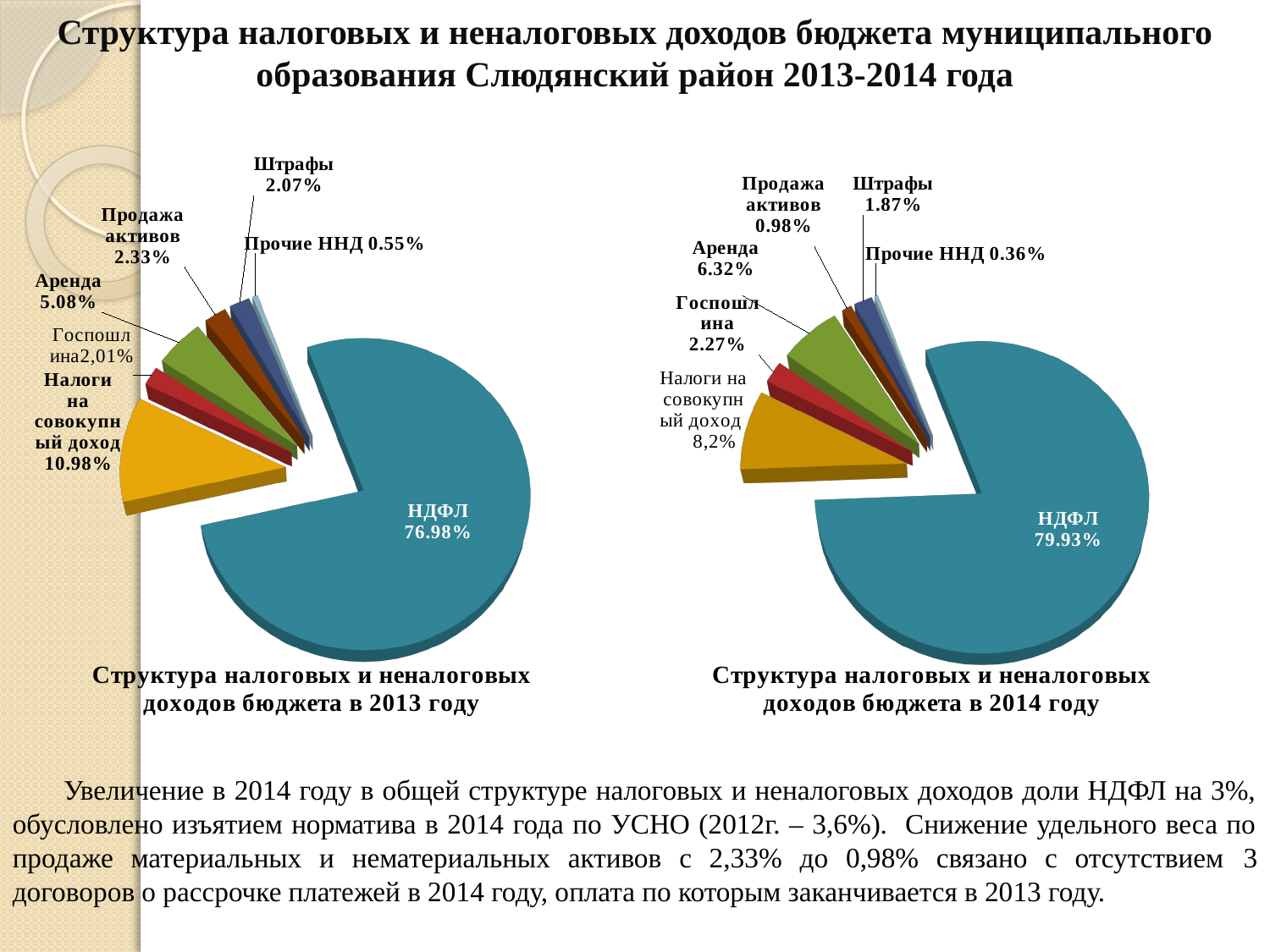
On the 2013 chart, what is the share of Штрафы? 2.07% On the 2014 chart, what is the share of Продажа активов? 0.98% On the 2013 chart (Структура налоговых и неналоговых доходов бюджета в 2013 году), what share does НДФЛ have? 76.98% On the 2014 chart, which category has the largest share? НДФЛ How many slices does the 2014 chart have? 7 On the 2014 chart, what is the share of Аренда? 6.32% By how many percentage points is the НДФЛ share on the 2014 chart larger than on the 2013 chart? 2.95 What type of chart is used on the left side of the slide? Pie chart On the 2013 chart, what is the share of Налоги на совокупный доход? 10.98% On the 2014 chart (Структура налоговых и неналоговых доходов бюджета в 2014 году), what share does НДФЛ have? 79.93% On the 2013 chart, which is larger: the share of Аренда or the share of Продажа активов? Аренда On the 2013 chart, which category has the smallest share? Прочие ННД